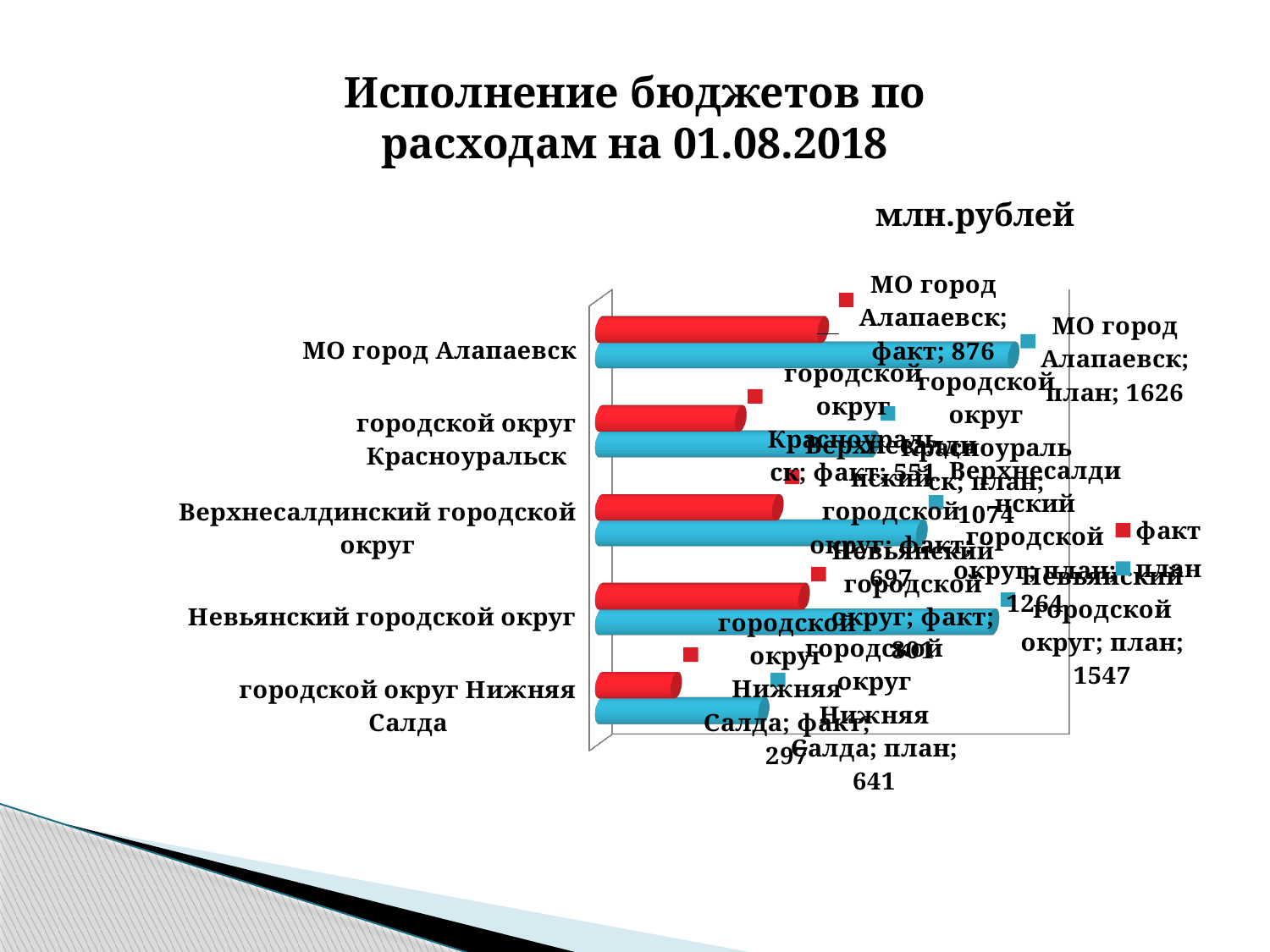
What unit of measurement is stated on the slide for the chart values? млн.рублей What is the план value for МО город Алапаевск? 1626 How many municipalities (categories) are shown in the chart? 5 What is the difference between план and факт for Невьянский городской округ? 746 What is the факт value for Невьянский городской округ? 801 Which municipality has the lowest факт value? городской округ Нижняя Салда What is the план value for городской округ Нижняя Салда? 641 What is the факт value for МО город Алапаевск? 876 What kind of chart is shown on the slide? bar chart Which is larger: the факт value for городской округ Красноуральск or the факт value for Верхнесалдинский городской округ? Верхнесалдинский городской округ Which municipality has the highest план value? МО город Алапаевск How many series does the legend list? 2